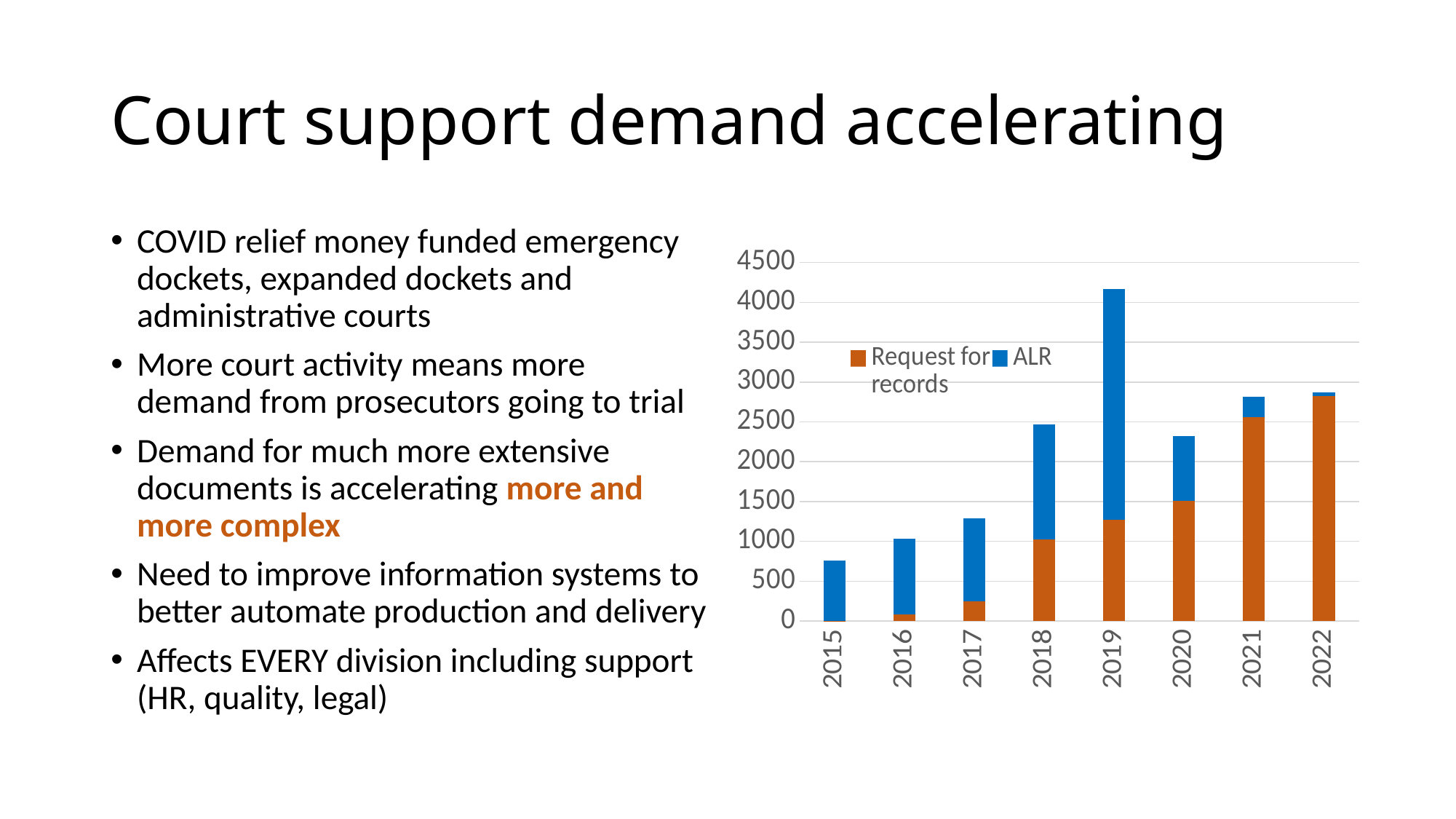
Which year has the lowest total bar in the chart? 2015 Which year has the highest total bar in the chart? 2019 What kind of chart is shown on the slide? stacked bar chart Is the total bar for 2020 greater or less than 2000? greater How many series does the chart legend list? 2 Which series is shown in orange in the chart? Request for records Is the total bar for 2019 greater or less than 4000? greater Is the total bar for 2015 greater or less than 1000? less Do the total bars rise or fall from 2015 to 2019? rise How many years are shown on the x axis of the chart? 8 Which year has a larger total bar, 2019 or 2020? 2019